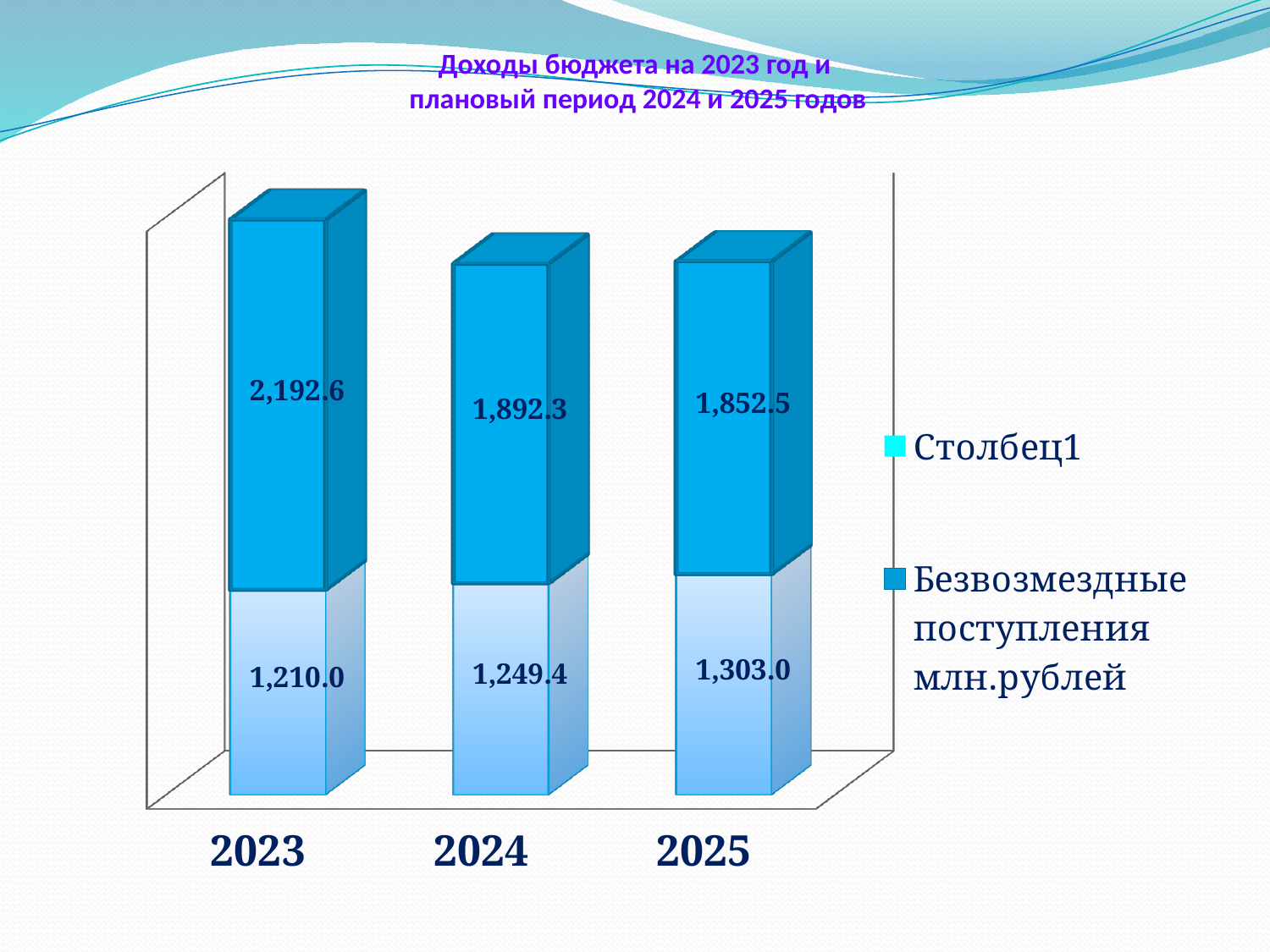
How many series does the legend list? 2 What is the value of the lower (light blue) segment for 2024? 1,249.4 What is the value of the upper (dark blue) segment for 2025? 1,852.5 Which year has the lowest value for the lower (light blue) segment? 2023 What is the value of the upper (dark blue) segment for 2023? 2,192.6 What type of chart is shown on the slide? Stacked bar chart Which year has the highest value for the upper (dark blue) segment? 2023 What is the value of the lower (light blue) segment for 2025? 1,303.0 What is the total of the stacked bar for 2023? 3,402.6 Which is larger: the lower segment value for 2024 or for 2025? 2025 How do the values of the lower (light blue) segment change from 2023 to 2025? They rise What is the difference between the upper segment values for 2023 and 2024? 300.3